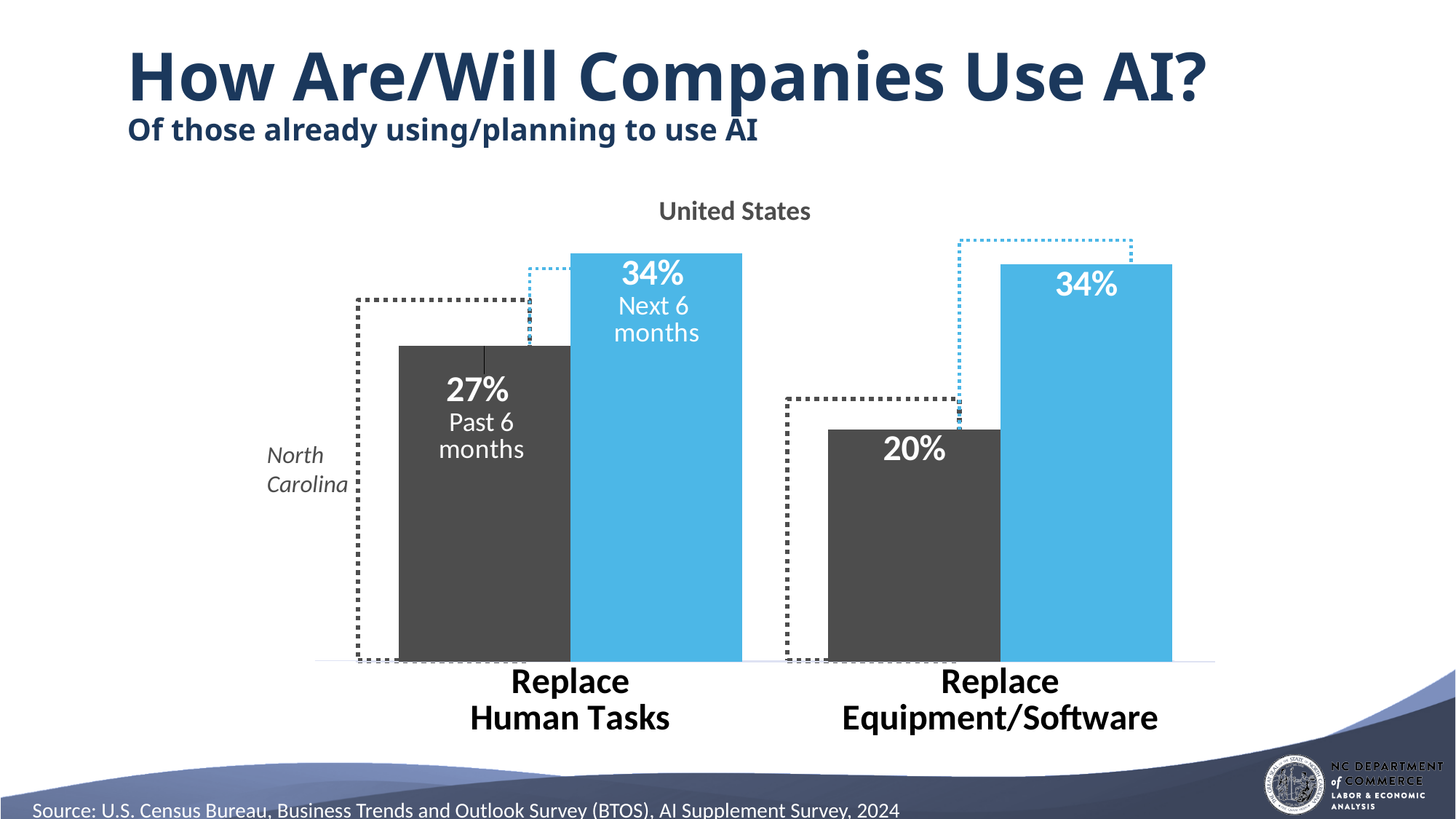
Which category has the lowest Past 6 months value? Replace Equipment/Software How many categories are shown on the x axis? 2 What is the value for Past 6 months under Replace Equipment/Software? 20% Which is larger for Replace Equipment/Software: the Past 6 months value or the Next 6 months value? Next 6 months What is the difference between the Next 6 months and Past 6 months values for Replace Equipment/Software? 14% What kind of chart is shown on the slide? bar chart What is the difference between the Next 6 months and Past 6 months values for Replace Human Tasks? 7% What colour are the Next 6 months bars? blue What is the value for Past 6 months under Replace Human Tasks? 27% What is the value for Next 6 months under Replace Human Tasks? 34% How many series does the chart show for the United States? 2 What is the value for Next 6 months under Replace Equipment/Software? 34%